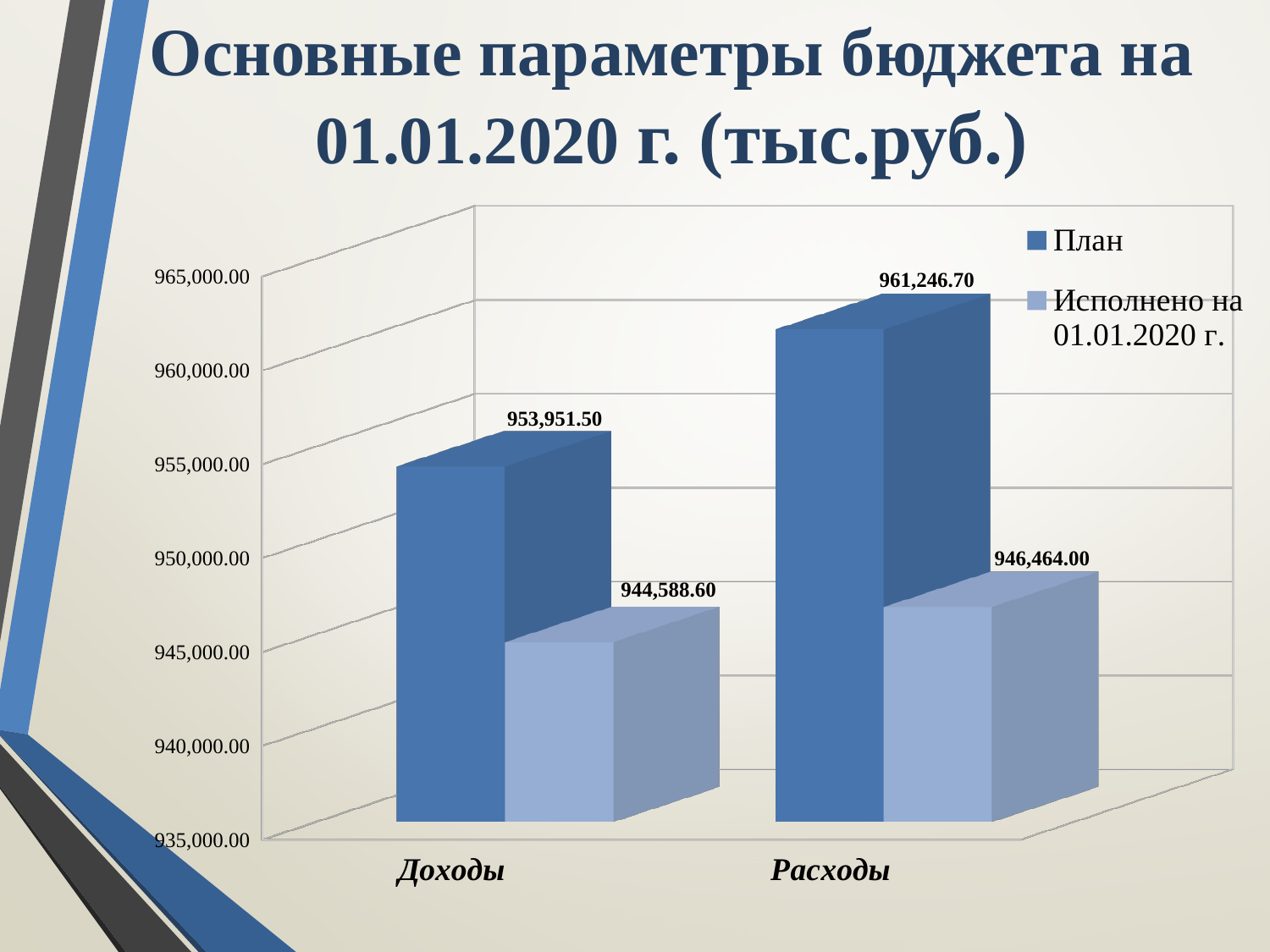
Which is larger: the Исполнено на 01.01.2020 г. value for Доходы or for Расходы? Расходы Which bar has the lowest value on the chart? Исполнено на 01.01.2020 г. for Доходы What type of chart is shown on the slide? Bar chart Which bar has the highest value on the chart? План for Расходы How many categories are shown on the x axis? 2 What is the difference between the План values for Расходы and Доходы? 7,295.20 What is the Исполнено на 01.01.2020 г. value for Расходы? 946,464.00 How many series does the legend list? 2 What is the Исполнено на 01.01.2020 г. value for Доходы? 944,588.60 What is the План value for Доходы? 953,951.50 What is the difference between the План and Исполнено на 01.01.2020 г. values for Расходы? 14,782.70 What is the План value for Расходы? 961,246.70